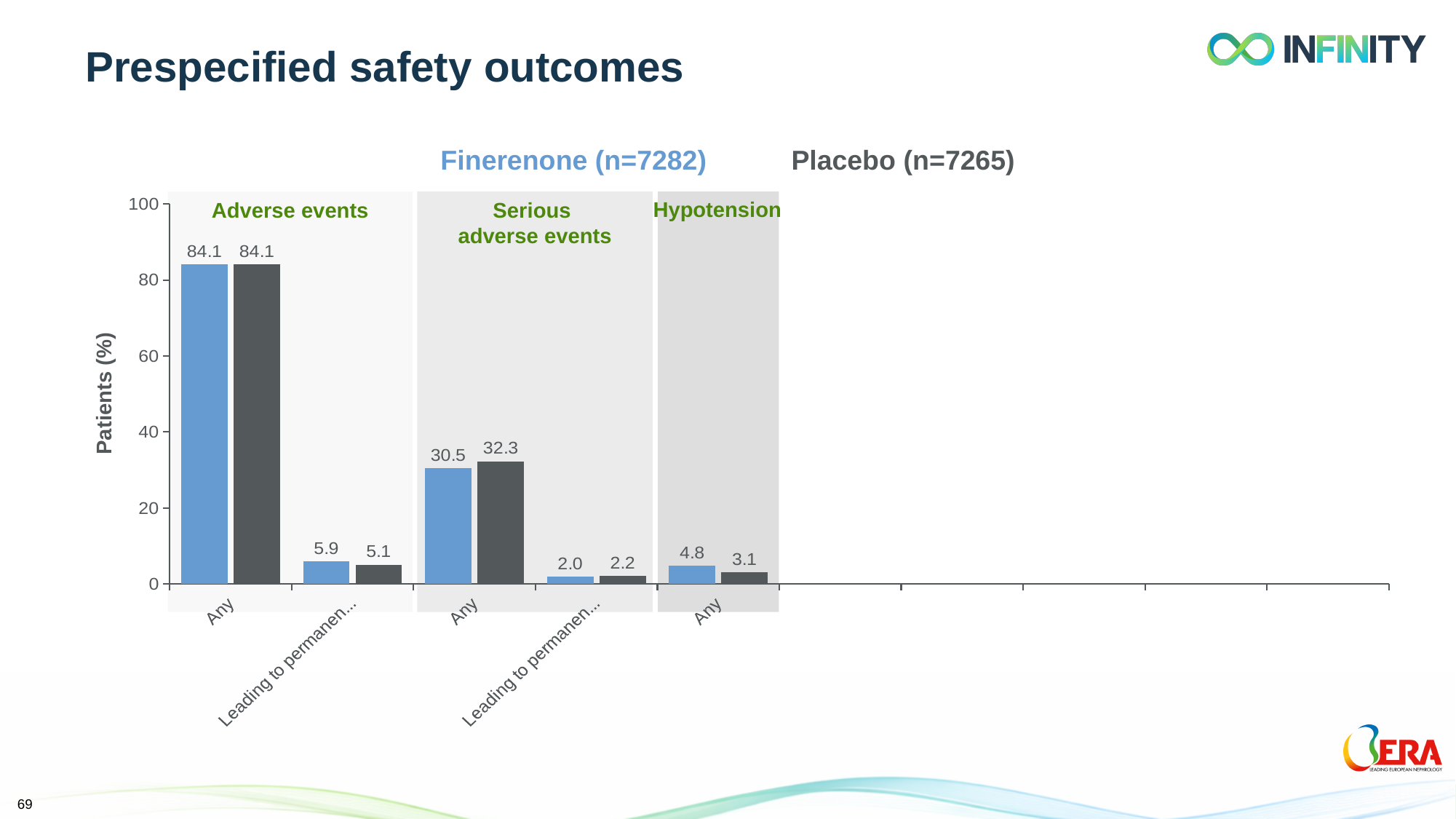
What is the difference between the Placebo and Finerenone values for 'Any' serious adverse events? 1.8 What is the Finerenone value for 'Any' adverse events? 84.1 What is the Finerenone value for 'Any' hypotension? 4.8 What type of chart is shown on the slide? Bar chart What is the Placebo value for 'Any' serious adverse events? 32.3 What is the difference between the Finerenone and Placebo values for 'Any' hypotension? 1.7 What is the Placebo value for 'Any' hypotension? 3.1 For 'Any' serious adverse events, which is larger: Finerenone or Placebo? Placebo Which category has the lowest Finerenone value? Leading to permanen... (Serious adverse events) For 'Any' hypotension, which is larger: Finerenone or Placebo? Finerenone Which category has the highest Finerenone value? Any (Adverse events) How many series does the chart show? 2